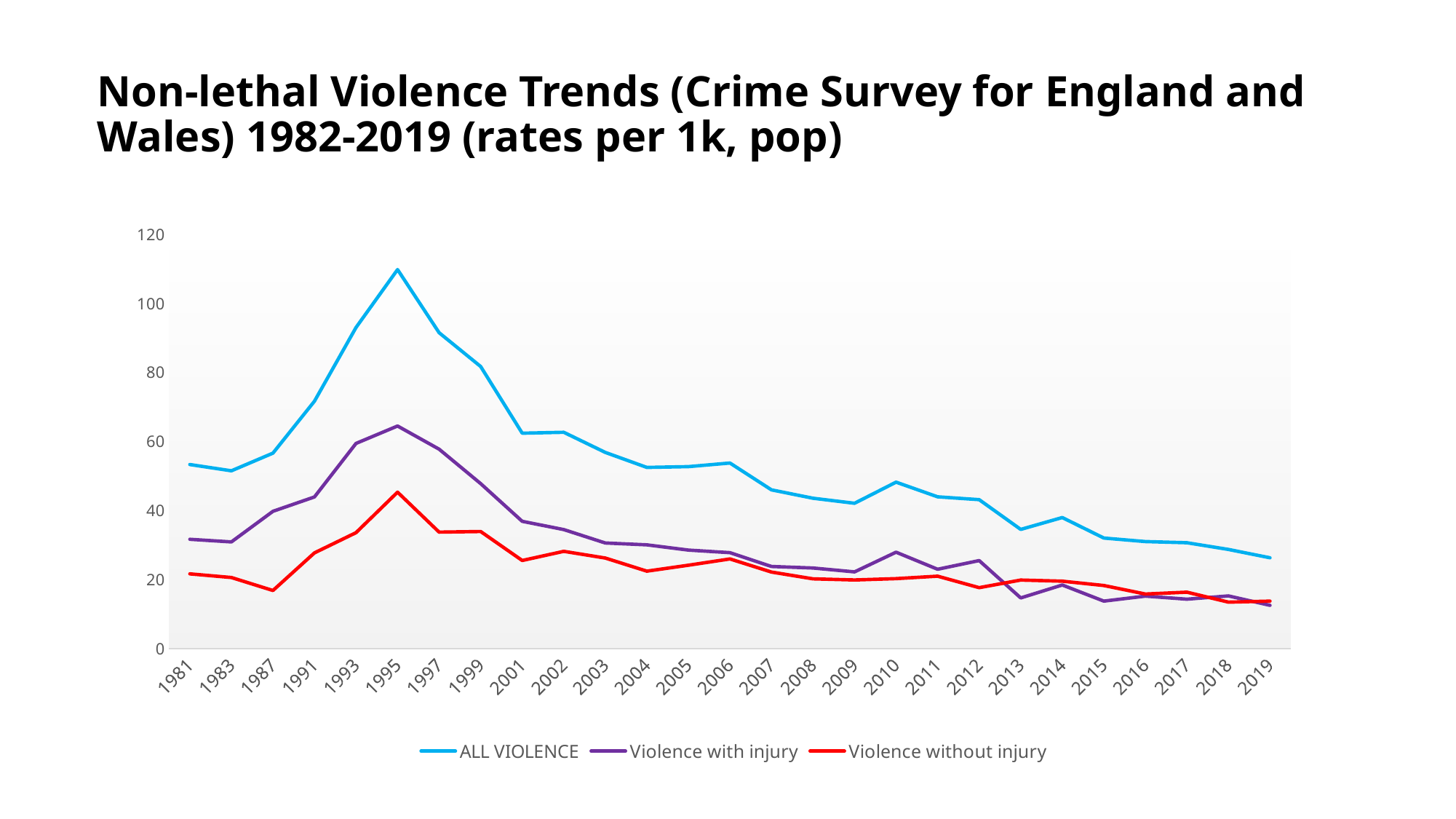
Which series is drawn in red? Violence without injury In which year does the Violence with injury series reach its highest value? 1995 Is the value for Violence without injury in 1987 greater or less than 20? less In which year does the ALL VIOLENCE series reach its highest value? 1995 Which series is higher in 2001, Violence with injury or Violence without injury? Violence with injury Is the value for ALL VIOLENCE in 1995 greater or less than 100? greater Does the ALL VIOLENCE series rise or fall between 1995 and 2019? fall How many years are labelled on the x axis? 27 Is the value for ALL VIOLENCE in 2019 greater or less than 40? less What is the title of the chart? Non-lethal Violence Trends (Crime Survey for England and Wales) 1982-2019 (rates per 1k, pop) How many series does the legend list? 3 What kind of chart is shown on the slide? line chart